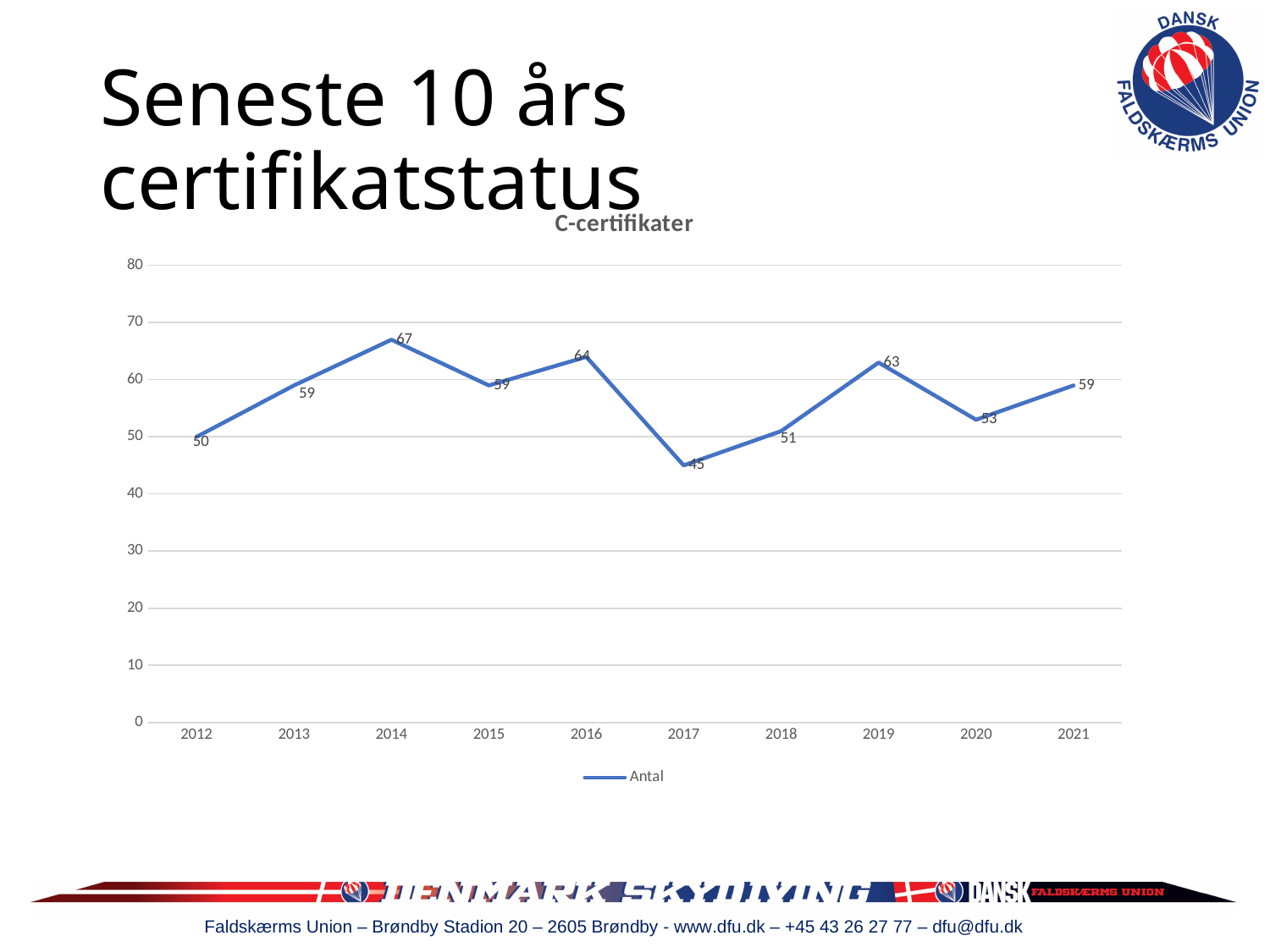
What is the value for 2014? 67 What is the value for 2017? 45 Which year has the highest value? 2014 What is the value for 2021? 59 What is the difference between the values for 2014 and 2017? 22 What type of chart is shown on the slide? line chart Which is larger, the value for 2016 or the value for 2019? 2016 Does the value rise or fall from 2019 to 2020? fall How many series does the legend list? 1 How many years are plotted on the x axis? 10 Which year has the lowest value? 2017 What is the title of the chart? C-certifikater